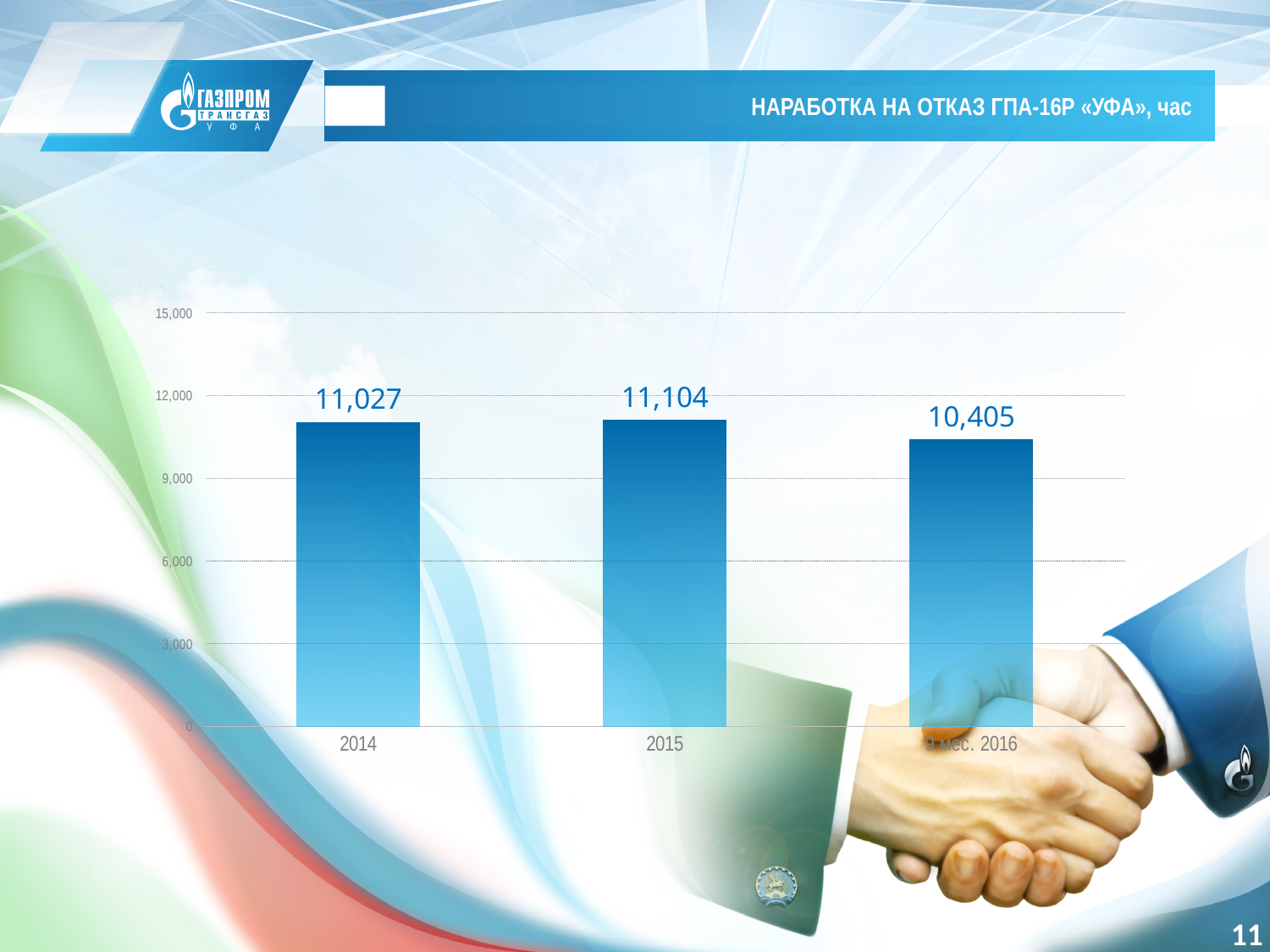
What is the difference between the values for 2015 and 2014? 77 What is the title of the chart? НАРАБОТКА НА ОТКАЗ ГПА-16Р «УФА», час What is the value for 2015? 11,104 What is the difference between the values for 2015 and 9 мес. 2016? 699 What kind of chart is shown on the slide? bar chart Is the value for 9 мес. 2016 greater or less than 12,000? less What is the value for 2014? 11,027 Which category has the lowest value? 9 мес. 2016 How many categories are shown on the x axis? 3 Which is larger, the value for 2014 or the value for 9 мес. 2016? 2014 Which category has the highest value? 2015 What is the value for 9 мес. 2016? 10,405